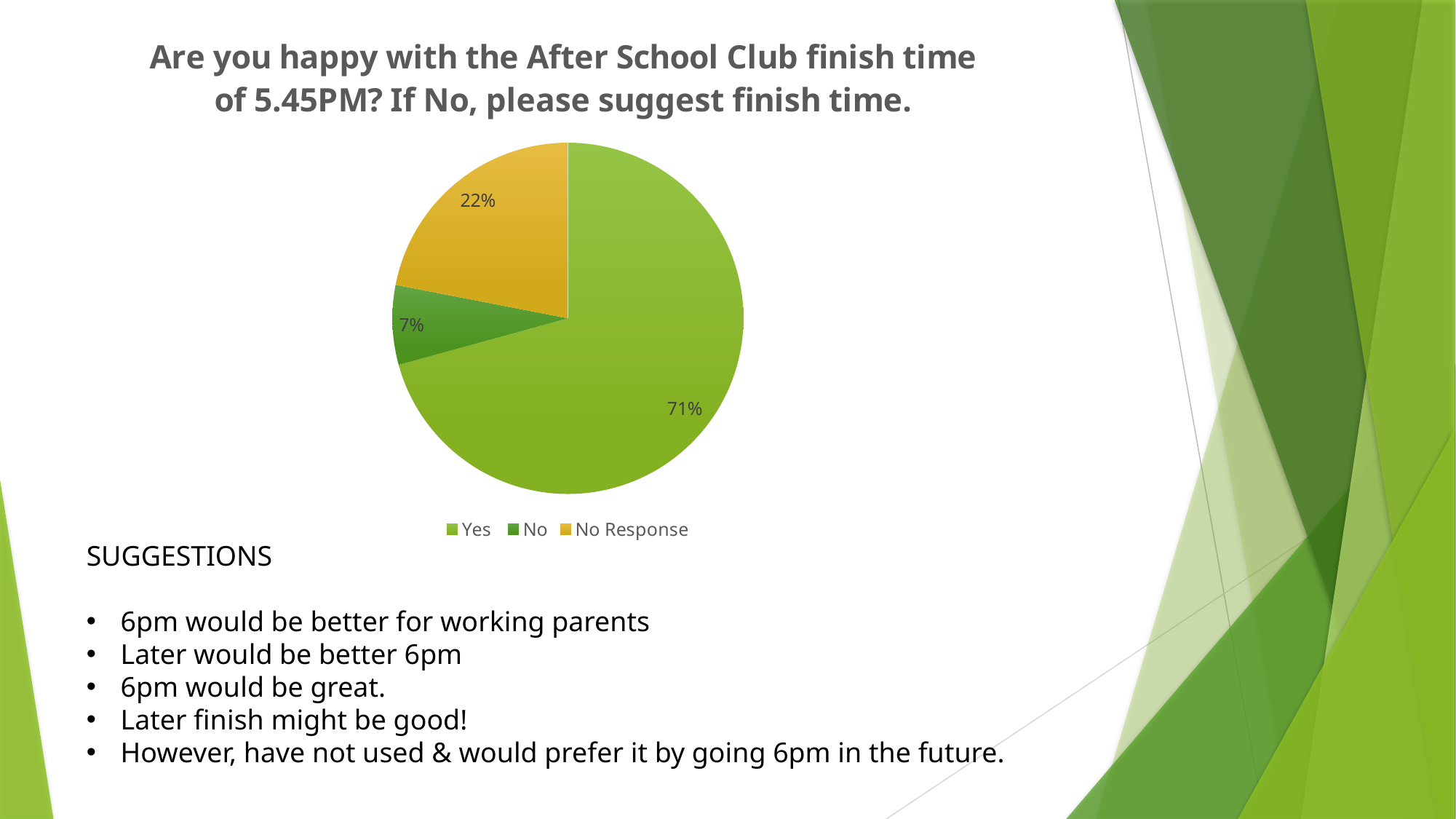
Which is larger, the share for No or the share for No Response? No Response Which response has the largest share of the pie? Yes How many entries does the legend list? 3 What percentage of respondents gave No Response? 22% What colour is the No Response slice? Yellow/gold What percentage of respondents answered Yes? 71% Which response has the smallest share of the pie? No What is the difference in percentage points between No Response and No? 15 What percentage of respondents answered No? 7% What is the difference in percentage points between Yes and No Response? 49 How many slices does the pie chart have? 3 What kind of chart is shown on the slide? Pie chart